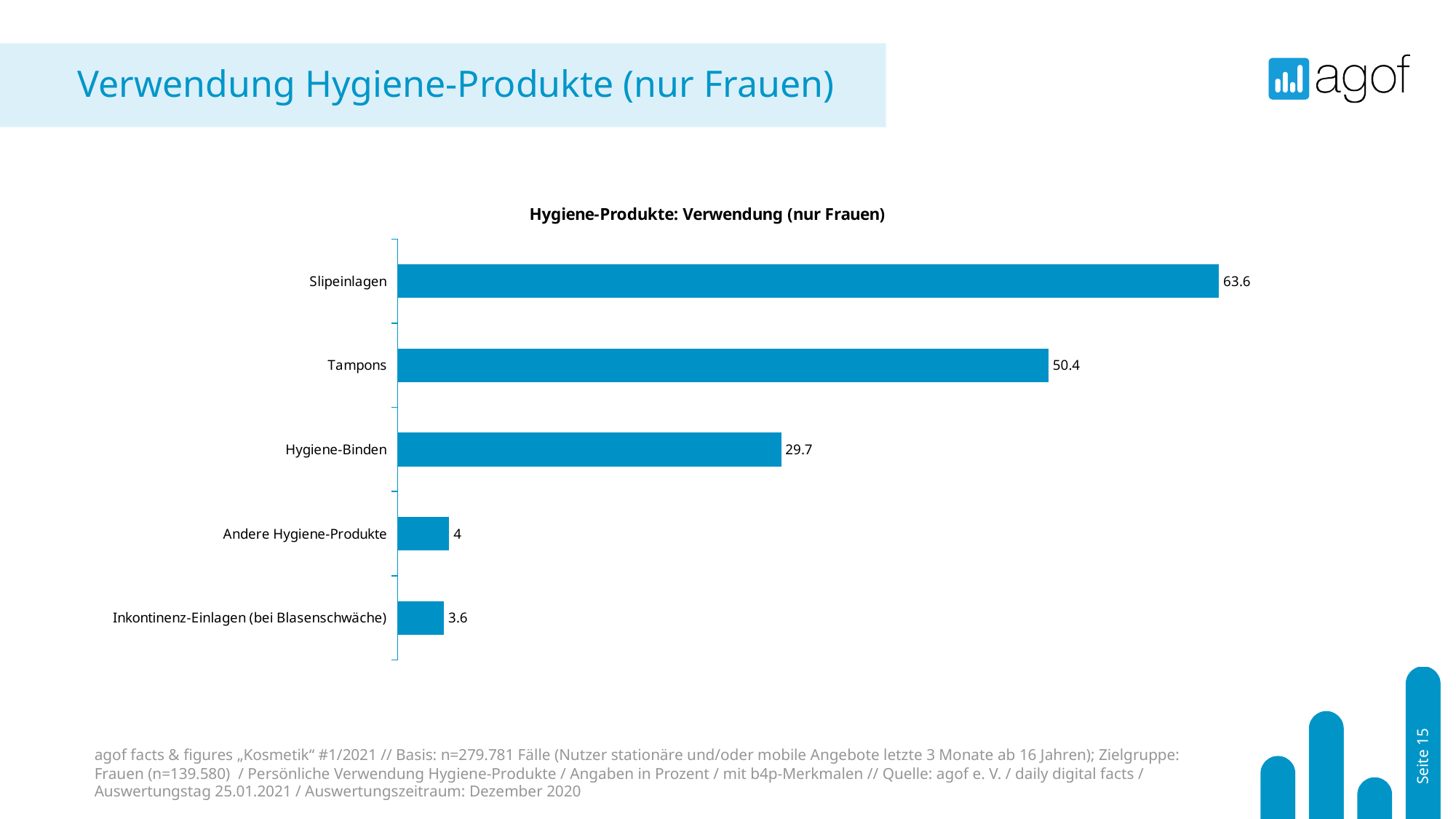
What kind of chart is shown on the slide? Bar chart What is the value for Andere Hygiene-Produkte? 4 What is the title of the chart? Hygiene-Produkte: Verwendung (nur Frauen) What is the value for Tampons? 50.4 What is the value for Hygiene-Binden? 29.7 What is the difference between the values for Slipeinlagen and Tampons? 13.2 Which category has the lowest value? Inkontinenz-Einlagen (bei Blasenschwäche) What is the value for Inkontinenz-Einlagen (bei Blasenschwäche)? 3.6 Which category has the highest value? Slipeinlagen What is the value for Slipeinlagen? 63.6 Which is larger, the value for Tampons or the value for Hygiene-Binden? Tampons How many categories are shown in the chart? 5